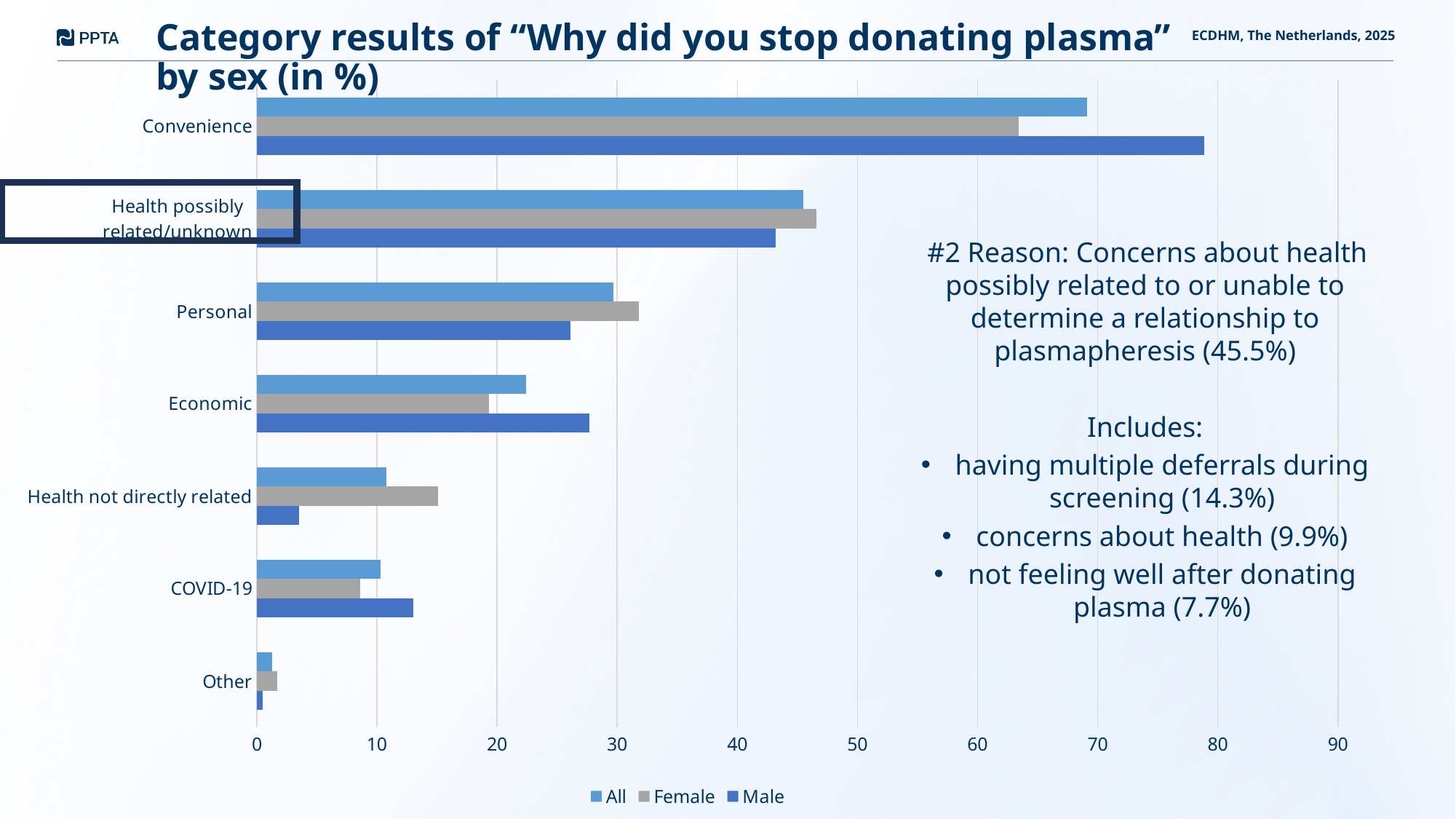
What kind of chart is shown on the slide? bar chart How many series does the legend list? 3 Is the Male value for Convenience greater or less than 70? greater Which category has the highest value for the Male series? Convenience What is the value for All in the Health possibly related/unknown category? 45.5% Is the Male value for Health not directly related greater or less than 10? less Which series is shown in grey in the legend? Female Which category has the lowest value for the All series? Other For Personal, which is larger: the Female value or the Male value? Female For Convenience, which is larger: the Male value or the Female value? Male How many categories are shown on the chart? 7 Is the Female value for Health not directly related greater or less than 10? greater